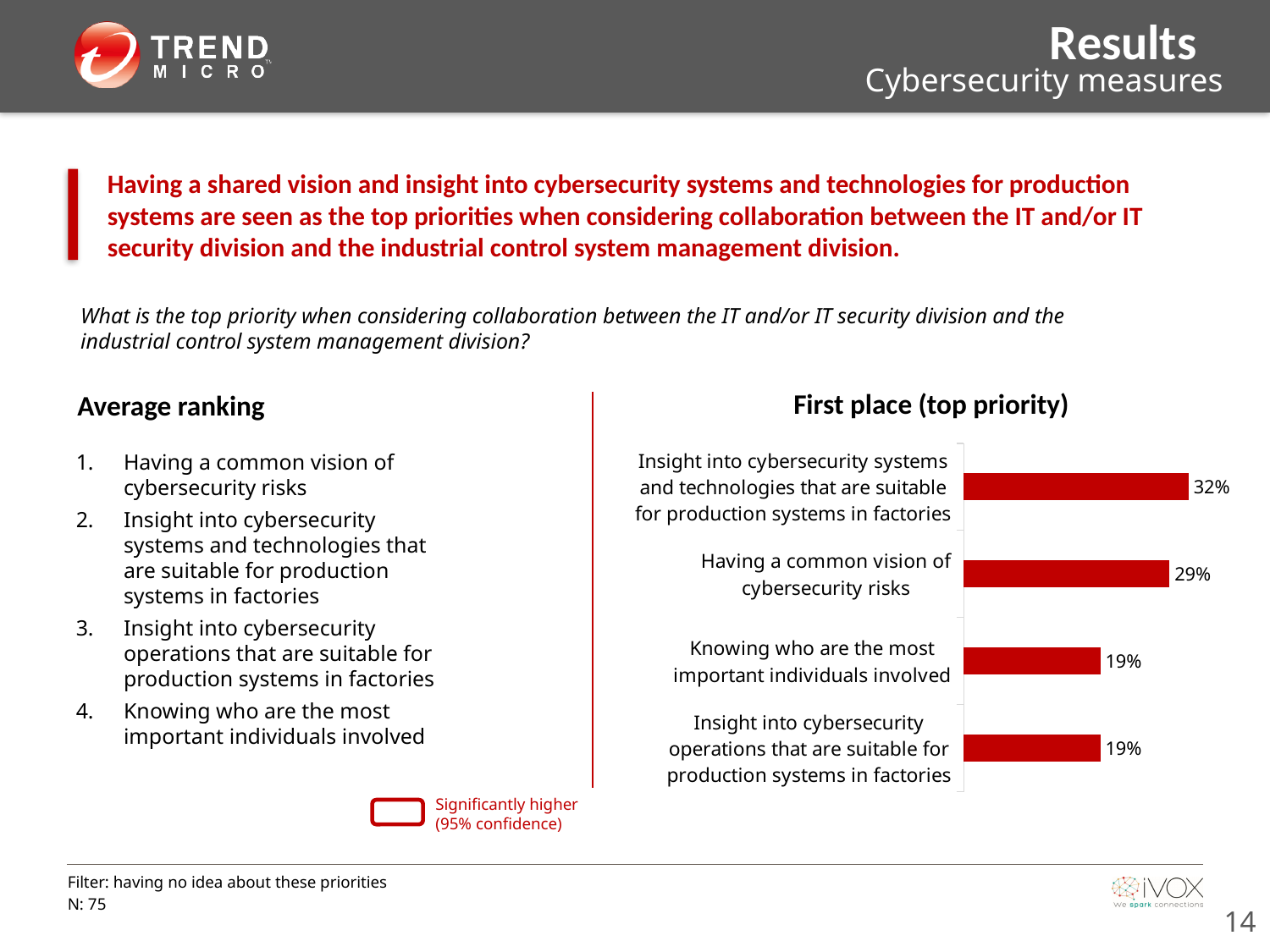
What is the title of the chart on the slide? First place (top priority) How many categories are shown in the First place (top priority) chart? 4 What colour are the bars in the First place (top priority) chart? Red What percentage of respondents chose 'Insight into cybersecurity systems and technologies that are suitable for production systems in factories' as their top priority? 32% Which is larger: the value for 'Having a common vision of cybersecurity risks' or the value for 'Insight into cybersecurity operations that are suitable for production systems in factories'? Having a common vision of cybersecurity risks What is the difference between the values for 'Insight into cybersecurity systems and technologies that are suitable for production systems in factories' and 'Having a common vision of cybersecurity risks'? 3% What is the difference between the values for 'Having a common vision of cybersecurity risks' and 'Knowing who are the most important individuals involved'? 10% Which two categories share the same value of 19% in the First place (top priority) chart? Knowing who are the most important individuals involved; Insight into cybersecurity operations that are suitable for production systems in factories What is the value for 'Knowing who are the most important individuals involved' in the First place (top priority) chart? 19% What type of chart is used to show the First place (top priority) results? Bar chart What is the value for 'Having a common vision of cybersecurity risks' in the First place (top priority) chart? 29% Which category has the highest value in the First place (top priority) chart? Insight into cybersecurity systems and technologies that are suitable for production systems in factories